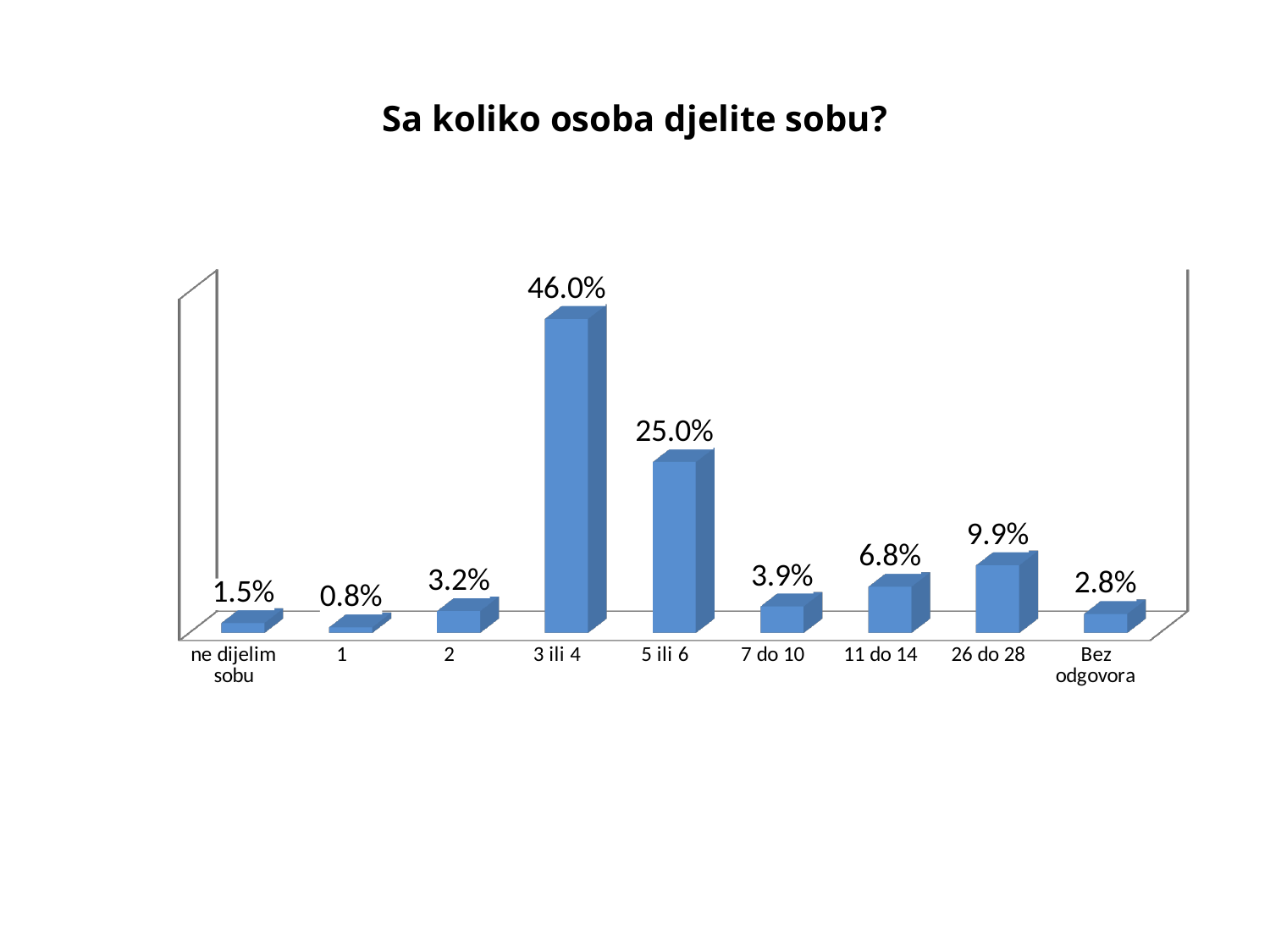
Which category has the lowest value? 1 What is the value for "5 ili 6"? 25.0% What is the value for "Bez odgovora"? 2.8% How many categories are shown on the x axis? 9 What kind of chart is shown on the slide? bar chart What is the difference between the values for "3 ili 4" and "5 ili 6"? 21.0% What is the title of the chart? Sa koliko osoba djelite sobu? Which category has the highest value? 3 ili 4 What is the value for "26 do 28"? 9.9% What is the value for "ne dijelim sobu"? 1.5% Which is larger, the value for "11 do 14" or the value for "7 do 10"? 11 do 14 What is the value for "3 ili 4"? 46.0%